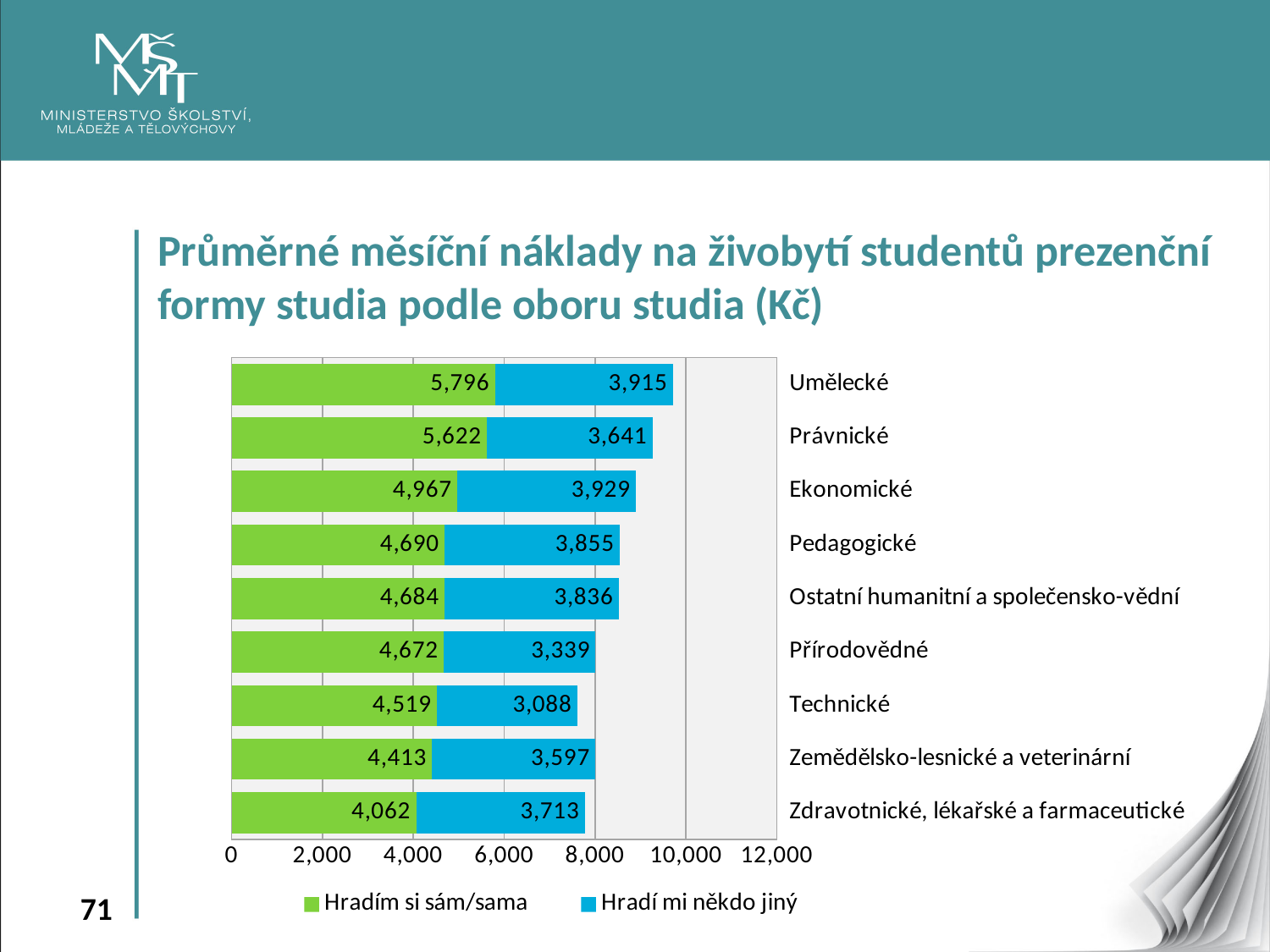
What is the value of 'Hradí mi někdo jiný' for Zemědělsko-lesnické a veterinární? 3,597 Which category has the lowest value for 'Hradí mi někdo jiný'? Technické What kind of chart is shown on the slide? Stacked bar chart How many study fields (categories) are shown in the chart? 9 Which is larger: the 'Hradí mi někdo jiný' value for Přírodovědné or for Pedagogické? Pedagogické What is the value of 'Hradím si sám/sama' for Umělecké? 5,796 How many series does the legend list? 2 Which category has the highest value for 'Hradím si sám/sama'? Umělecké What is the total of the stacked bar for Umělecké? 9,711 What is the difference between the 'Hradím si sám/sama' values for Umělecké and Zdravotnické, lékařské a farmaceutické? 1,734 Is the total bar length for Technické greater or less than 8,000? less Which colour represents the series 'Hradí mi někdo jiný'? Blue